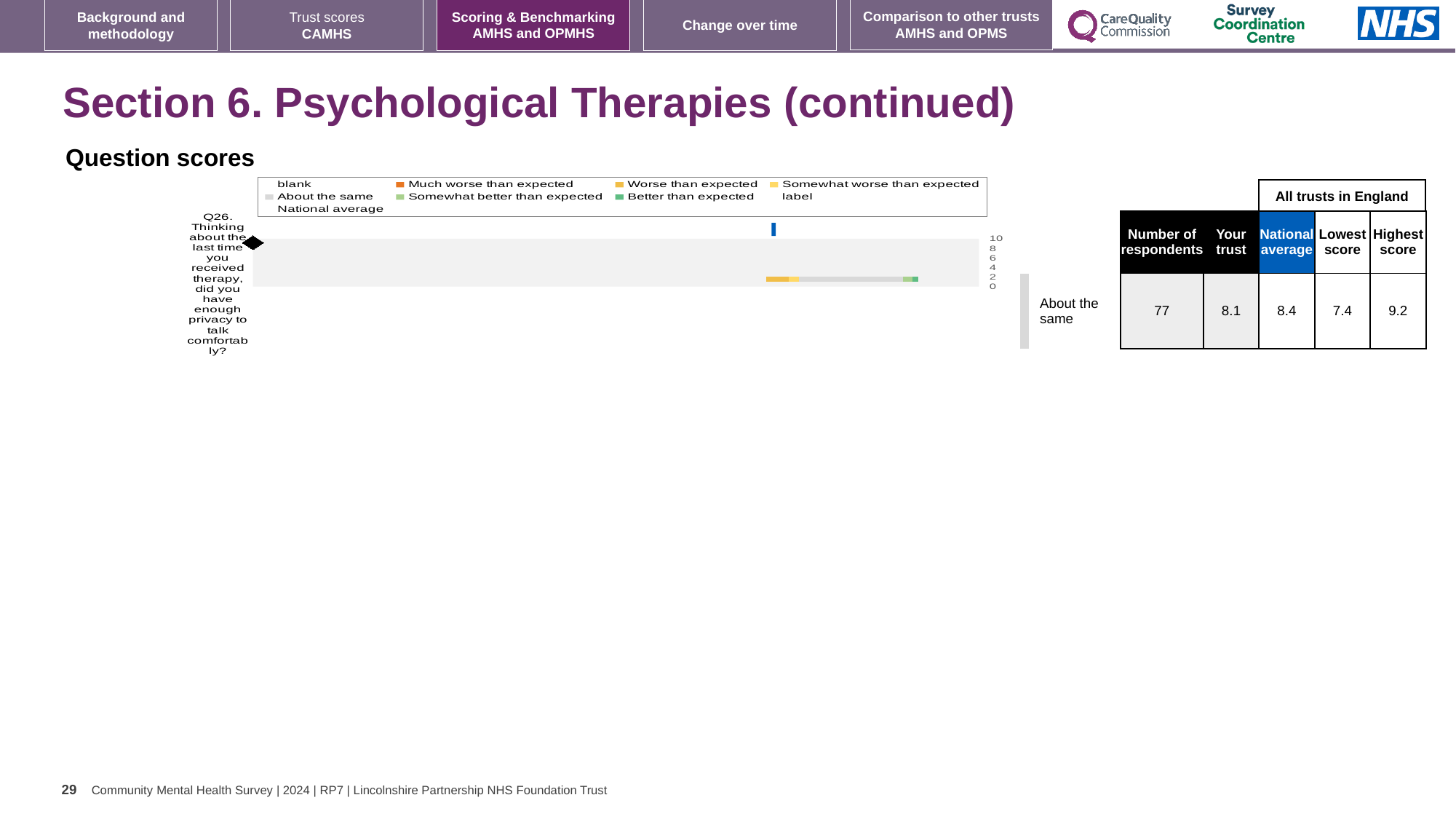
In the table next to the chart, is the 'Your trust' score for Q26 larger or smaller than the national average? smaller What is the highest value shown on the chart's axis? 10 In the table next to the chart, what is the 'Your trust' score for Q26? 8.1 How many entries does the chart legend list? 9 Which question is plotted in the chart? Q26. Thinking about the last time you received therapy, did you have enough privacy to talk comfortably? What kind of chart is shown under 'Question scores'? bar chart In the table next to the chart, what is the difference between the highest score and the lowest score for Q26? 1.8 In the table next to the chart, what is the highest score among all trusts in England for Q26? 9.2 In the table next to the chart, what is the lowest score among all trusts in England for Q26? 7.4 In the table next to the chart, what is the national average for Q26? 8.4 In the table next to the chart, what is the number of respondents for Q26? 77 How many questions (categories) are plotted in the chart? 1